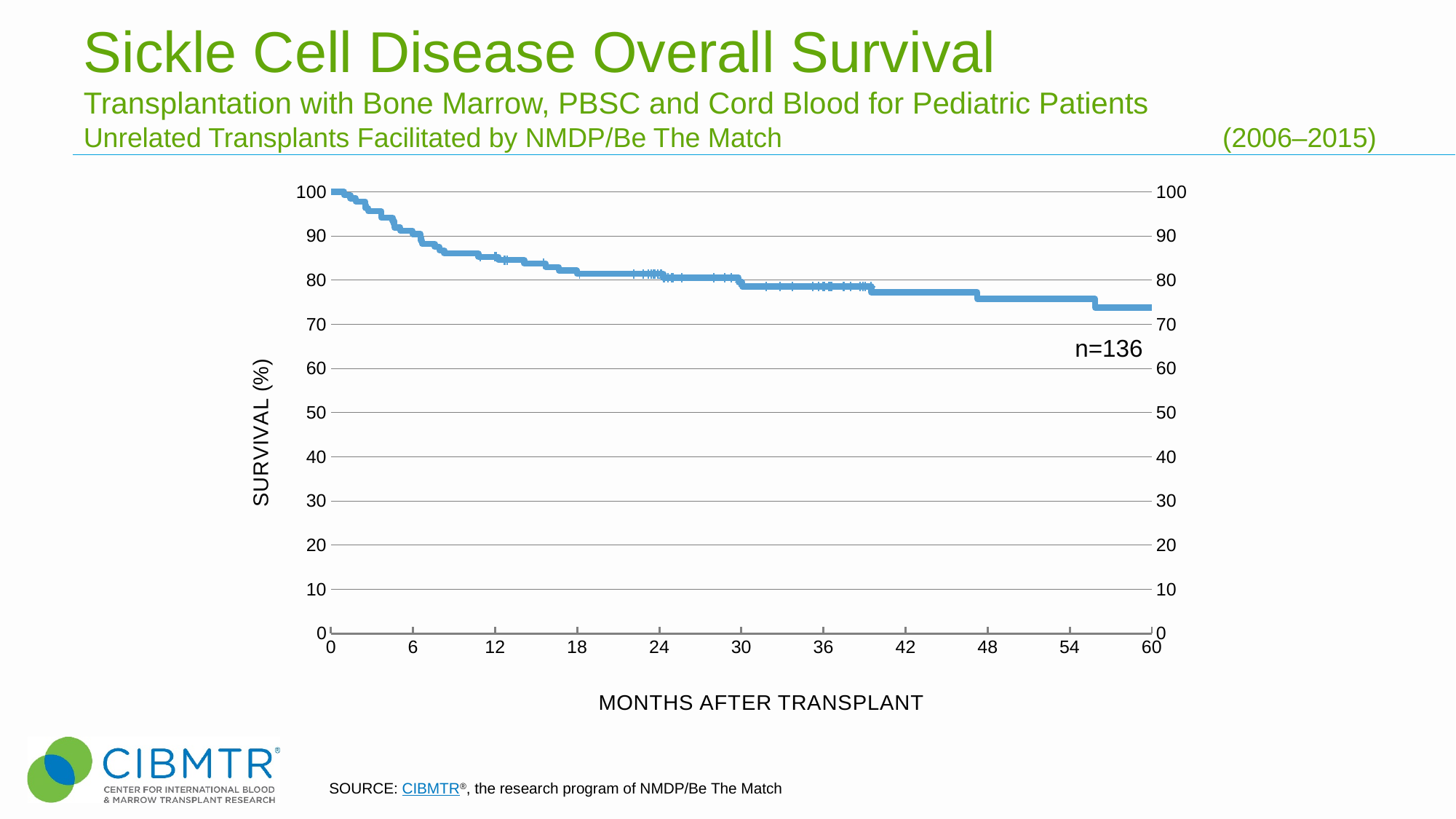
Is the survival value at 12 months after transplant greater or less than 90? less What is the number of patients (n) shown on the chart? n=136 Is the survival value at 60 months after transplant greater or less than 80? less What is the highest value shown on the y axis? 100 Does the survival curve rise or fall as months after transplant increase? fall What kind of chart is shown on the slide? line chart What is the survival percentage at 0 months after transplant? 100 How many tick marks are labelled on the x axis? 11 Is the survival value at 12 months after transplant greater or less than 80? greater What is the label of the x axis? MONTHS AFTER TRANSPLANT